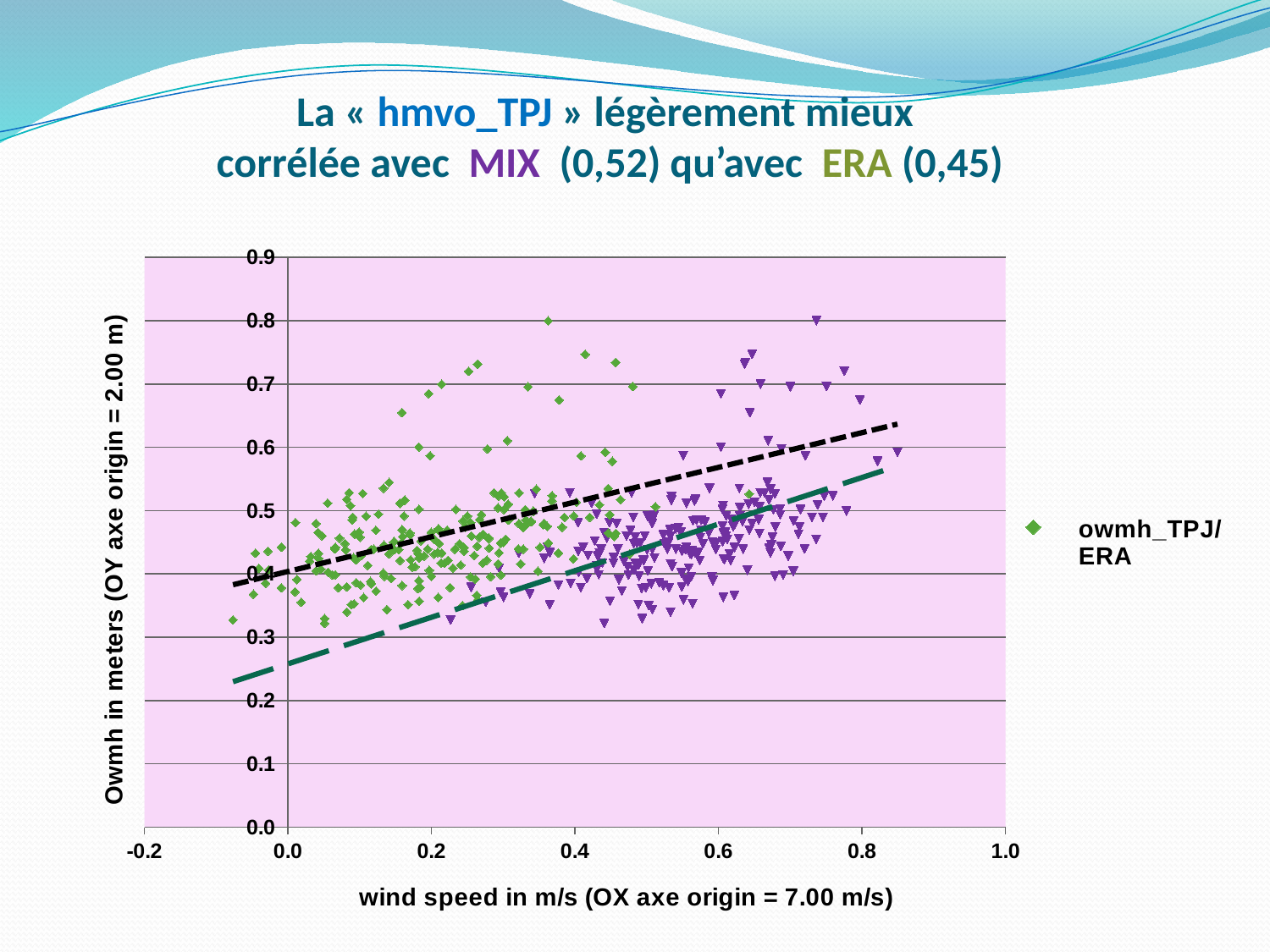
What kind of chart is shown on the slide? scatter chart According to the slide title, is hmvo_TPJ more strongly correlated with MIX or with ERA? MIX What is the highest tick value shown on the horizontal axis of the chart? 1.0 What is the highest tick value shown on the vertical axis of the chart? 0.9 According to the slide title, what is the correlation value of hmvo_TPJ with MIX? 0,52 Do the dashed trend lines on the chart rise or fall as wind speed increases along the x axis? rise What is the title of the vertical axis of the chart? Owmh in meters (OY axe origin = 2.00 m) What is the series name shown in the chart's legend? owmh_TPJ/ERA According to the slide title, what is the correlation value of hmvo_TPJ with ERA? 0,45 What is the difference between the two correlation values given in the slide title (0,52 and 0,45)? 0,07 What is the lowest tick value shown on the horizontal axis of the chart? -0.2 How many series does the chart's legend list? 1